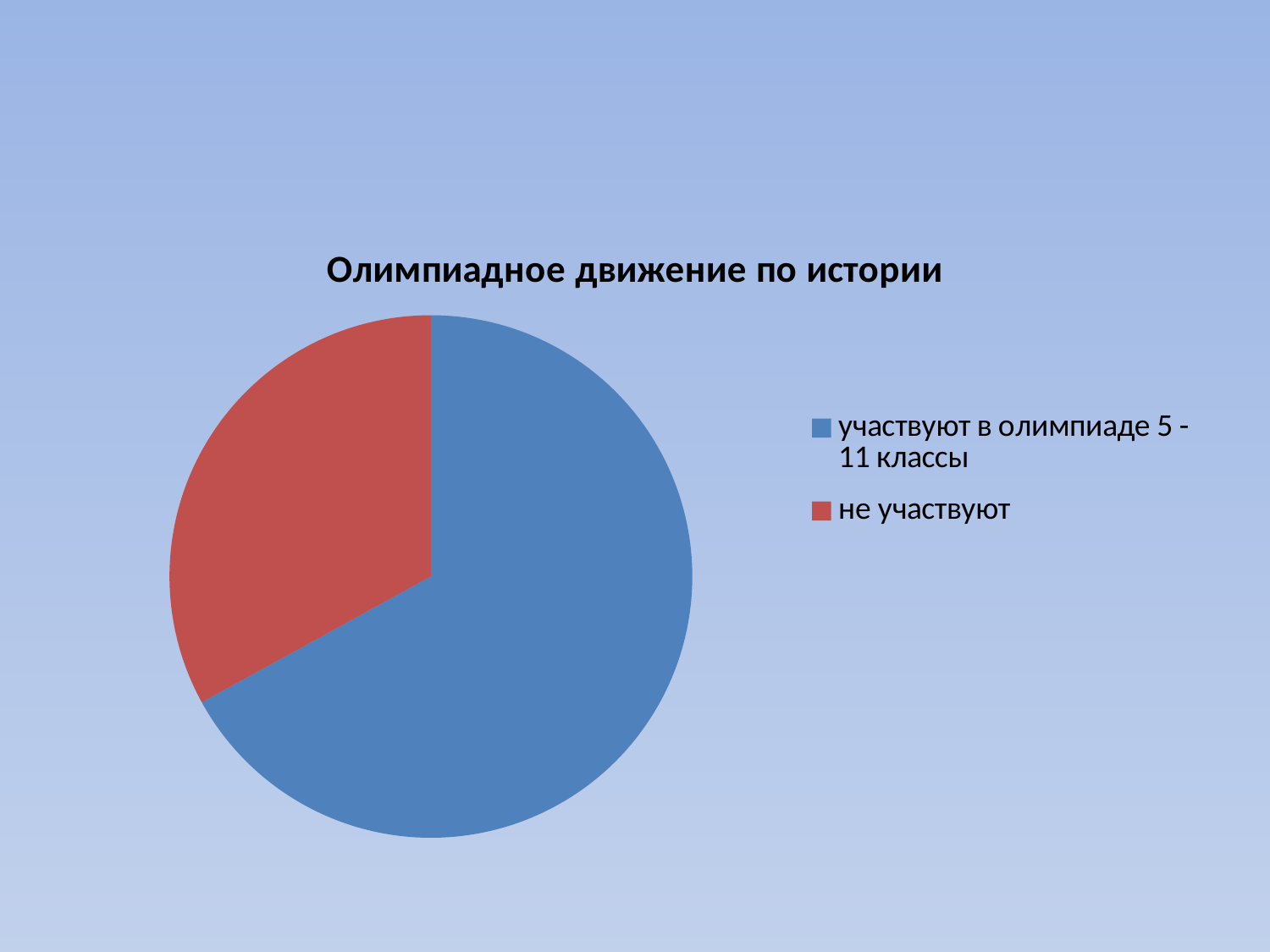
What is the title of the chart? Олимпиадное движение по истории What colour is the slice for "не участвуют"? red How many entries does the legend list? 2 What kind of chart is shown on the slide? pie chart Which category has the smallest slice of the pie? не участвуют Which category has the largest slice of the pie? участвуют в олимпиаде 5 - 11 классы How many slices does the pie chart have? 2 Which slice is larger: "участвуют в олимпиаде 5 - 11 классы" or "не участвуют"? участвуют в олимпиаде 5 - 11 классы